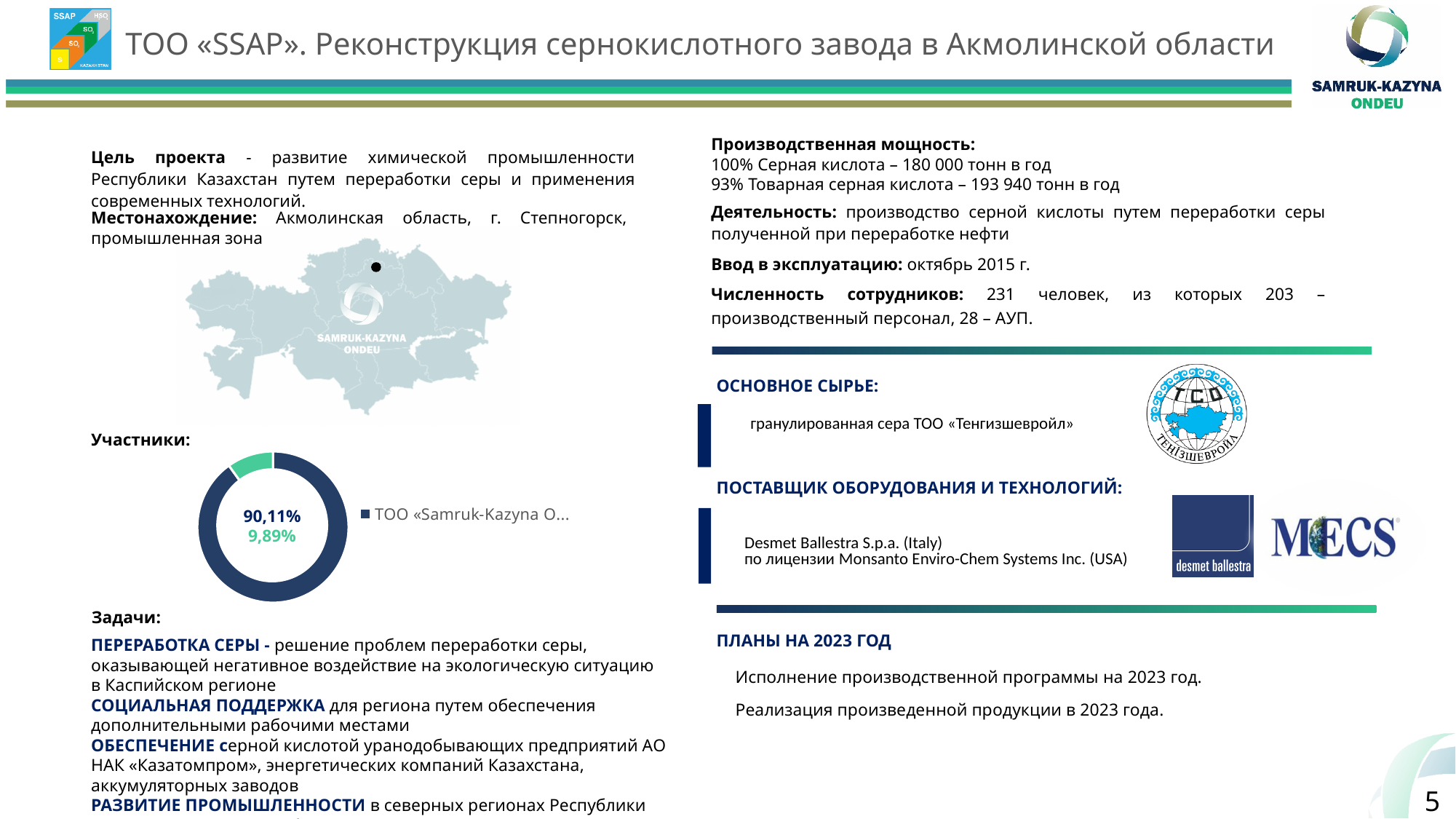
What is the value of the largest slice in the «Участники:» pie chart? 90,11% What is the value of the slice corresponding to the legend entry beginning «ТОО «Samruk-Kazyna O…» in the «Участники:» pie chart? 90,11% What colour is the largest slice in the «Участники:» pie chart? dark blue What is the difference between the two slices in the «Участники:» pie chart? 80,22% Is the green slice of the «Участники:» pie chart greater or less than 50%? less In the «Участники:» pie chart, which slice is larger: the dark blue one or the green one? the dark blue one How many entries does the legend of the «Участники:» pie chart list? 1 How many slices does the «Участники:» pie chart have? 2 What kind of chart is shown under «Участники:»? pie chart (donut) What share of the «Участники:» pie chart does the green slice represent? 9,89% What is the value of the smallest slice in the «Участники:» pie chart? 9,89% What share of the «Участники:» pie chart does the dark blue slice represent? 90,11%